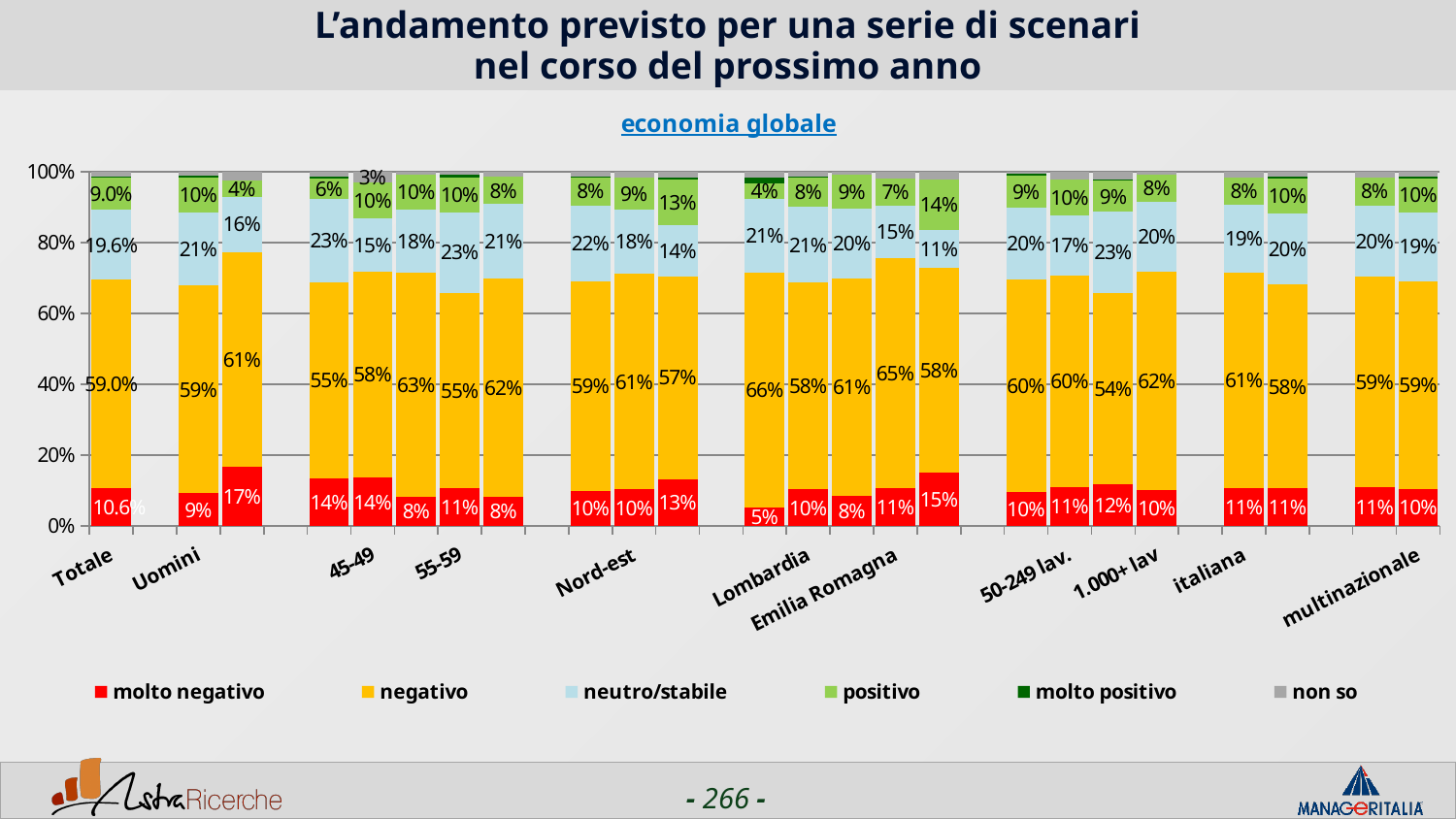
What is the 'negativo' value for Totale? 59.0% What is the 'positivo' value for multinazionale? 10% What scenario is named in the subtitle above the chart? economia globale Which series is shown in red in the legend? molto negativo What is the 'molto negativo' value for Totale? 10.6% Which has the larger 'negativo' value, 50-249 lav. or 1.000+ lav? 1.000+ lav What is the 'neutro/stabile' value for Uomini? 21% What is the difference between the 'neutro/stabile' and 'positivo' values for Totale? 10.6% What kind of chart is shown on the slide? bar chart How many series does the legend list? 6 What is the 'molto negativo' value for italiana? 11% What is the 'negativo' value for Nord-est? 61%